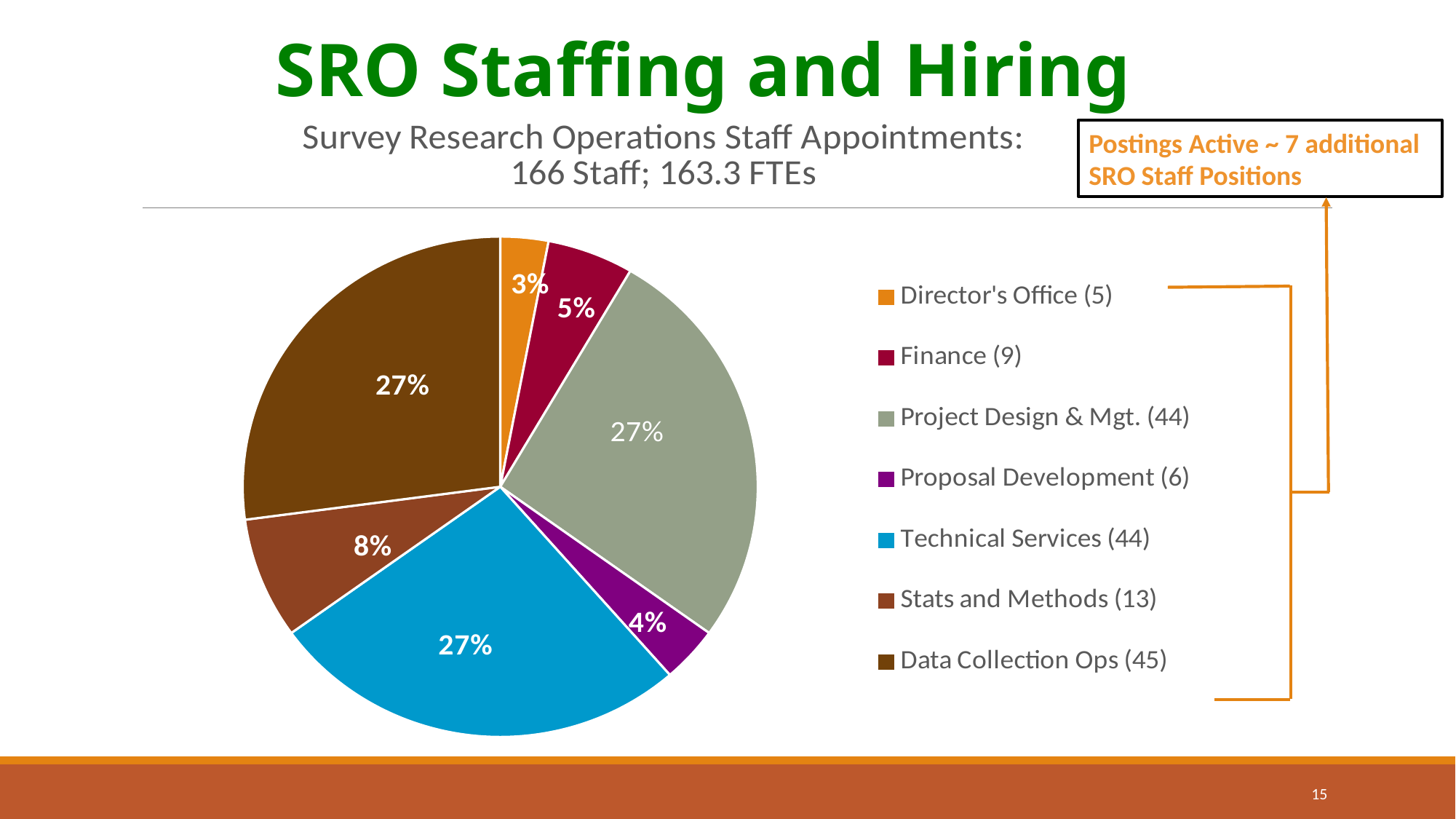
Which slice is larger, Proposal Development or Director's Office? Proposal Development What share of the pie does Proposal Development represent? 4% What share of the pie does the Director's Office represent? 3% What share of the pie does Stats and Methods represent? 8% Which category has the smallest slice of the pie? Director's Office How many slices does the pie chart have? 7 According to the legend, how many staff are in Technical Services? 44 Which slice is larger, Finance or Stats and Methods? Stats and Methods What share of the pie does Finance represent? 5% What kind of chart is shown on the slide? pie chart What share of the pie does Technical Services represent? 27% By how many percentage points does the Stats and Methods share exceed the Finance share? 3 percentage points